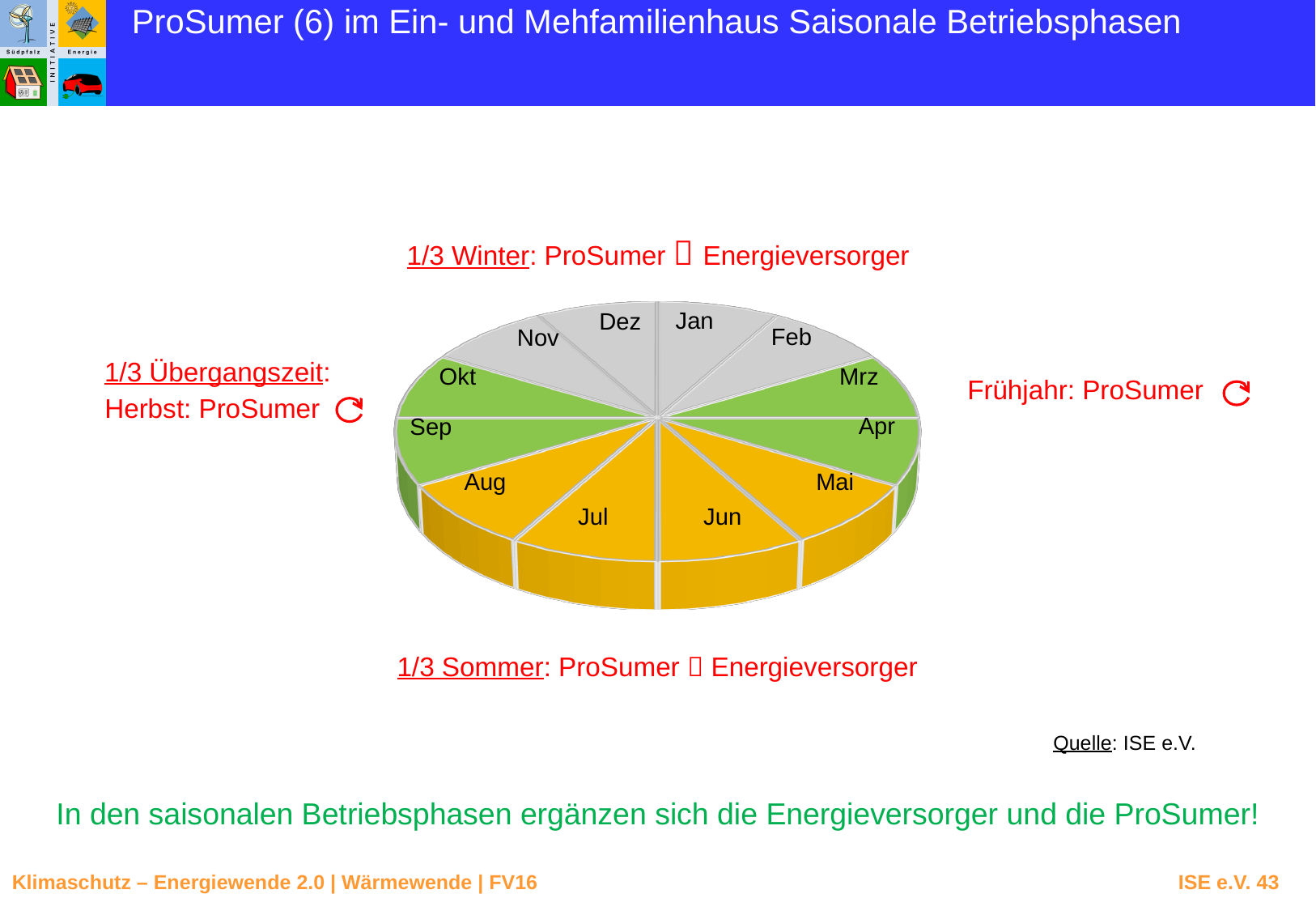
Which season label is placed above the pie chart? 1/3 Winter: ProSumer Energieversorger Which slice label comes directly after Jun going clockwise around the pie chart? Jul What is the source given for the chart? ISE e.V. How many slices of the pie chart are coloured yellow? 4 According to the slide, what share of the year does the Sommer phase cover? 1/3 What kind of chart is shown on the slide? pie chart How many slices of the pie chart are coloured grey? 4 How many slices does the pie chart have? 12 Which months are shown as green slices in the pie chart? Mrz, Apr, Sep, Okt According to the slide, what share of the year does the Winter phase cover? 1/3 According to the slide, what share of the year does the Übergangszeit cover? 1/3 Which months are shown as grey slices in the pie chart? Nov, Dez, Jan, Feb